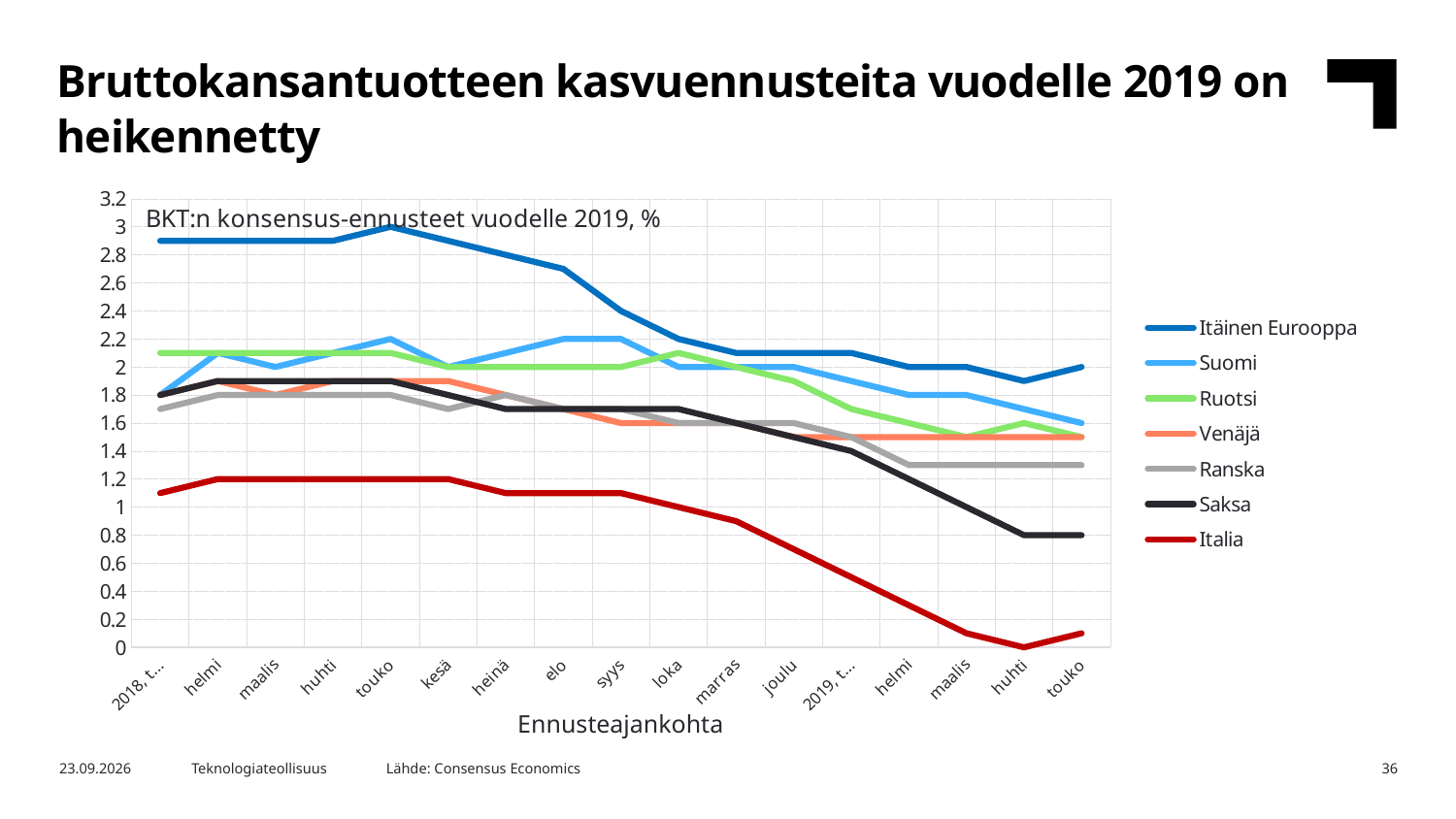
Is the value for Saksa at 2019 huhti greater or less than 1? less What is the title shown inside the chart area? BKT:n konsensus-ennusteet vuodelle 2019, % At 2019 touko, which is larger: the value for Ruotsi or the value for Ranska? Ruotsi Which series has the lowest value at the last point (2019 touko)? Italia Which series has the highest value at the last point (2019 touko)? Itäinen Eurooppa Does the Italia series generally rise or fall from left to right along the x axis? fall What kind of chart is shown on the slide? line chart How many points are there along the x axis of the chart? 17 How many series does the chart legend list? 7 At 2019 touko, which is larger: the value for Saksa or the value for Italia? Saksa Is the value for Itäinen Eurooppa at 2018 helmi greater or less than 2.8? greater Is the value for Italia at 2019 helmi greater or less than 0.6? less